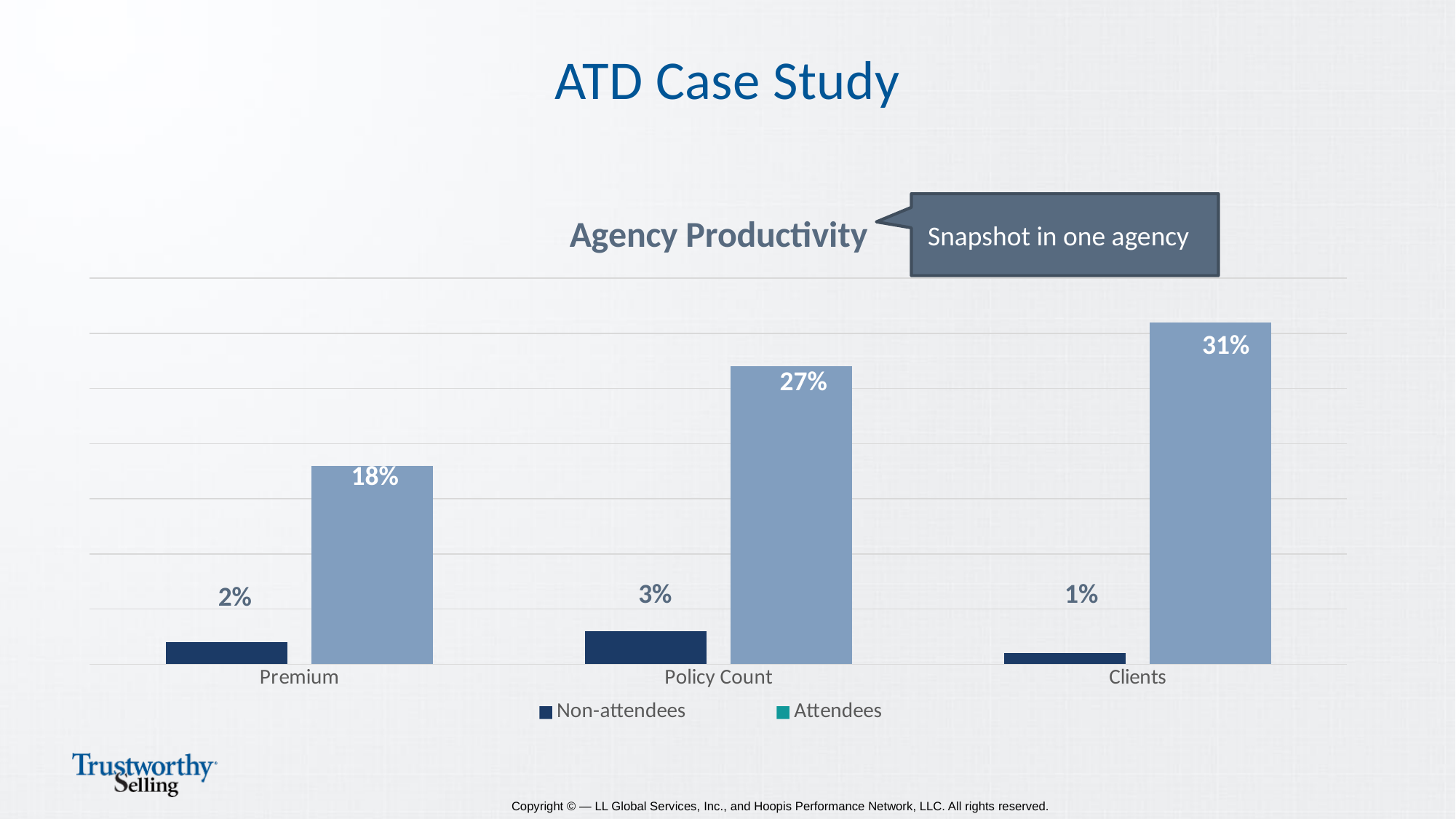
What is the value for Attendees in the Clients category? 31% What is the value for Non-attendees in the Clients category? 1% What is the value for Attendees in the Premium category? 18% Which category has the lowest Non-attendees value? Clients How many series does the legend list? 2 Which is larger, the Attendees value for Premium or the Attendees value for Policy Count? Policy Count Which category has the highest Attendees value? Clients How many categories are shown on the x axis? 3 What kind of chart is shown on the slide? Bar chart What is the value for Non-attendees in the Policy Count category? 3% What is the title of the chart? Agency Productivity What is the difference between the Attendees and Non-attendees values for Policy Count? 24%